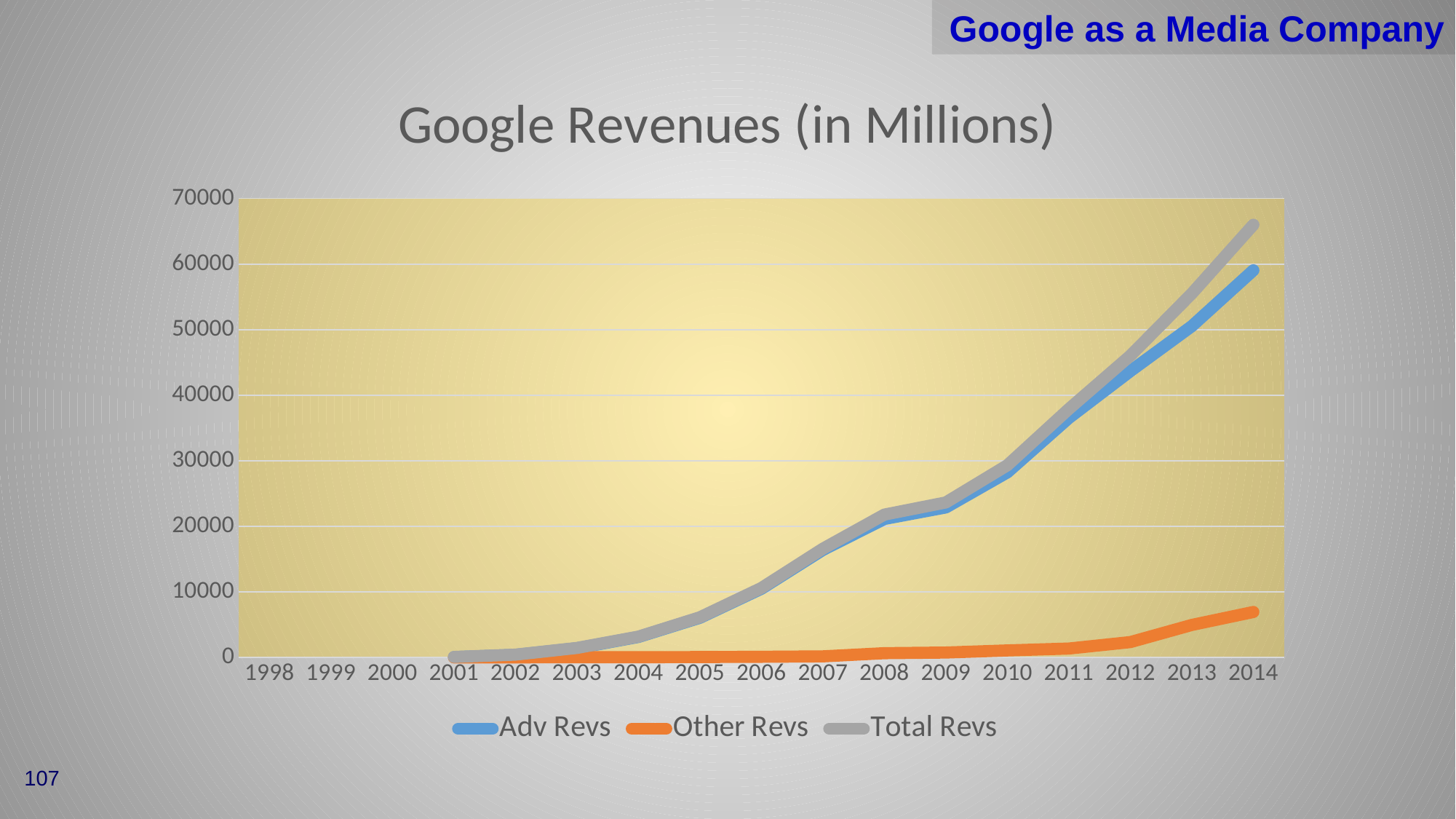
How many series does the legend list? 3 In 2014, which is larger: Adv Revs or Other Revs? Adv Revs Is the value for Total Revs in 2014 greater or less than 60000? greater Which series has the lowest value in 2014? Other Revs What kind of chart is shown on the slide? line chart Is the value for Adv Revs in 2014 greater or less than 50000? greater Which series has the highest value in 2014? Total Revs What is the title of the chart? Google Revenues (in Millions) Do the Total Revs values rise or fall from 2001 to 2014? rise How many years are shown on the x axis? 17 Is the value for Total Revs in 2005 greater or less than 10000? less